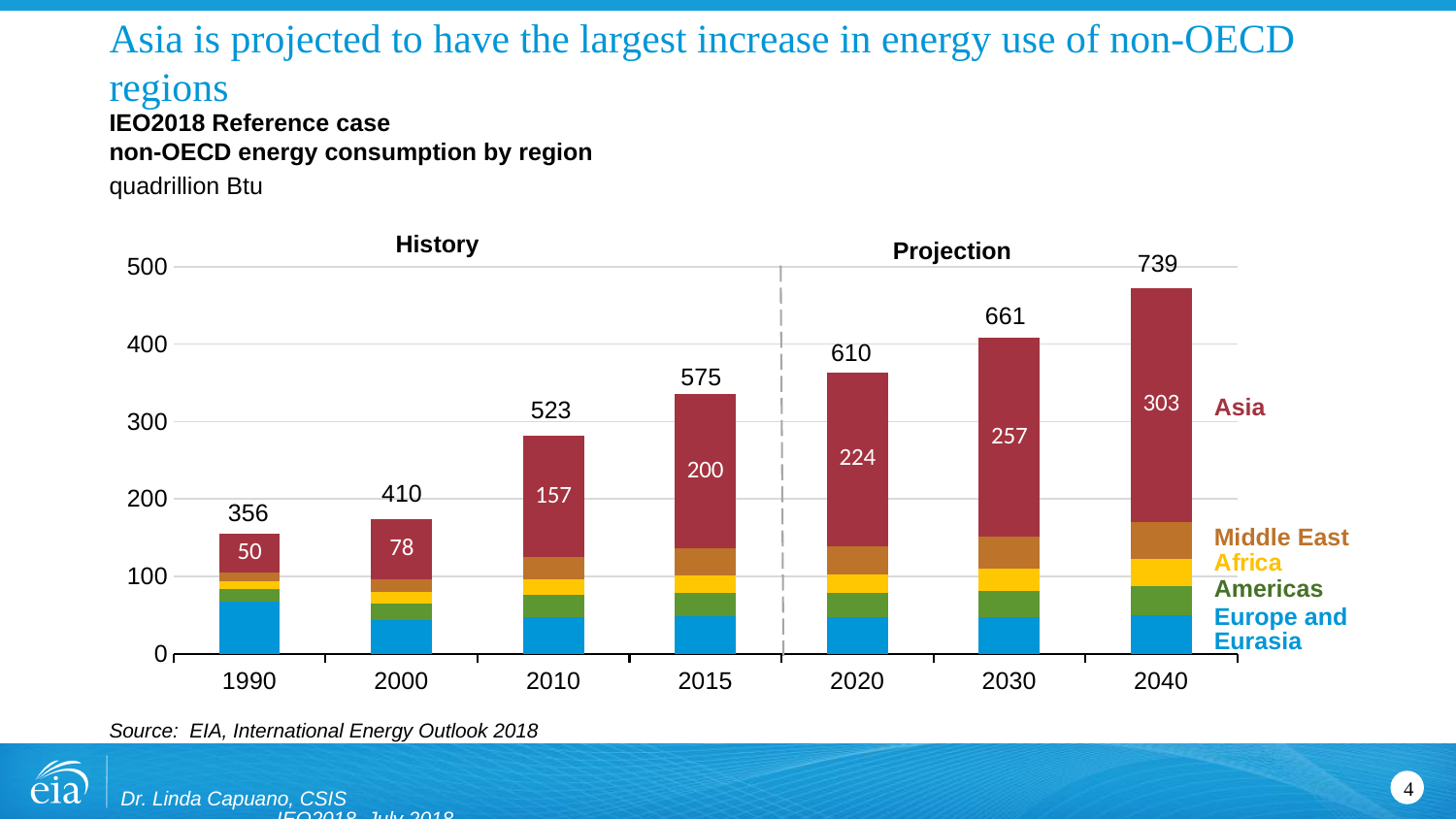
What is the Asia value printed on the bar for 1990? 50 Do the values printed above the bars rise or fall from 1990 to 2040? rise What is the difference between the Asia values printed for 2040 and 2015? 103 Which year has the lowest Asia value printed on its bar? 1990 What is the Asia value printed on the bar for 2040? 303 How many regions does the legend list? 5 How many years are shown along the x axis of the chart? 7 What value is printed above the bar for 2010? 523 What kind of chart is shown on the slide? stacked bar chart Is the Asia value printed for 2030 larger or smaller than the Asia value printed for 2020? larger What value is printed above the bar for 2020? 610 Which year has the highest value printed above its bar? 2040